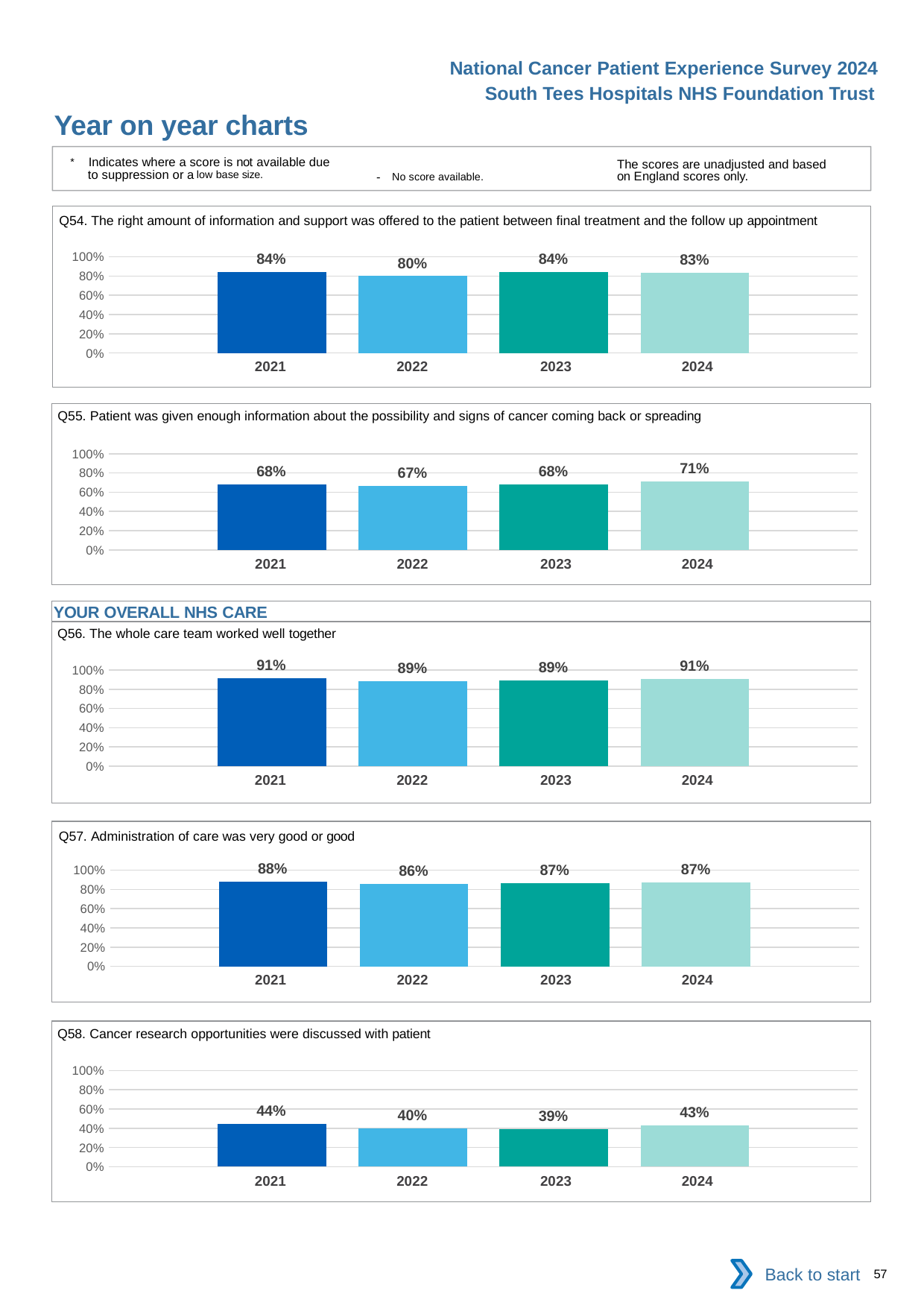
What type of chart is used for Q57 (administration of care was very good or good)? Bar chart In the Q54 chart (right amount of information and support offered between final treatment and follow up), what is the value for 2022? 80% In the Q58 chart (cancer research opportunities were discussed with patient), what is the value for 2024? 43% In the Q55 chart (information about the possibility and signs of cancer coming back), which year has the highest value? 2024 In the Q57 chart (administration of care was very good or good), what is the difference between the 2021 and 2022 values? 2% How many years (bars) are shown in the Q54 chart? 4 In the Q55 chart (information about the possibility and signs of cancer coming back), what is the difference between the 2024 and 2022 values? 4% In the Q56 chart (the whole care team worked well together), which year has the lowest value, 2022 or 2021? 2022 In the Q57 chart (administration of care was very good or good), which year has the highest value? 2021 In the Q58 chart (cancer research opportunities were discussed with patient), is the value for 2021 greater or less than 60%? less In the Q58 chart (cancer research opportunities were discussed with patient), which year has the lowest value? 2023 In the Q56 chart (the whole care team worked well together), what is the value for 2021? 91%